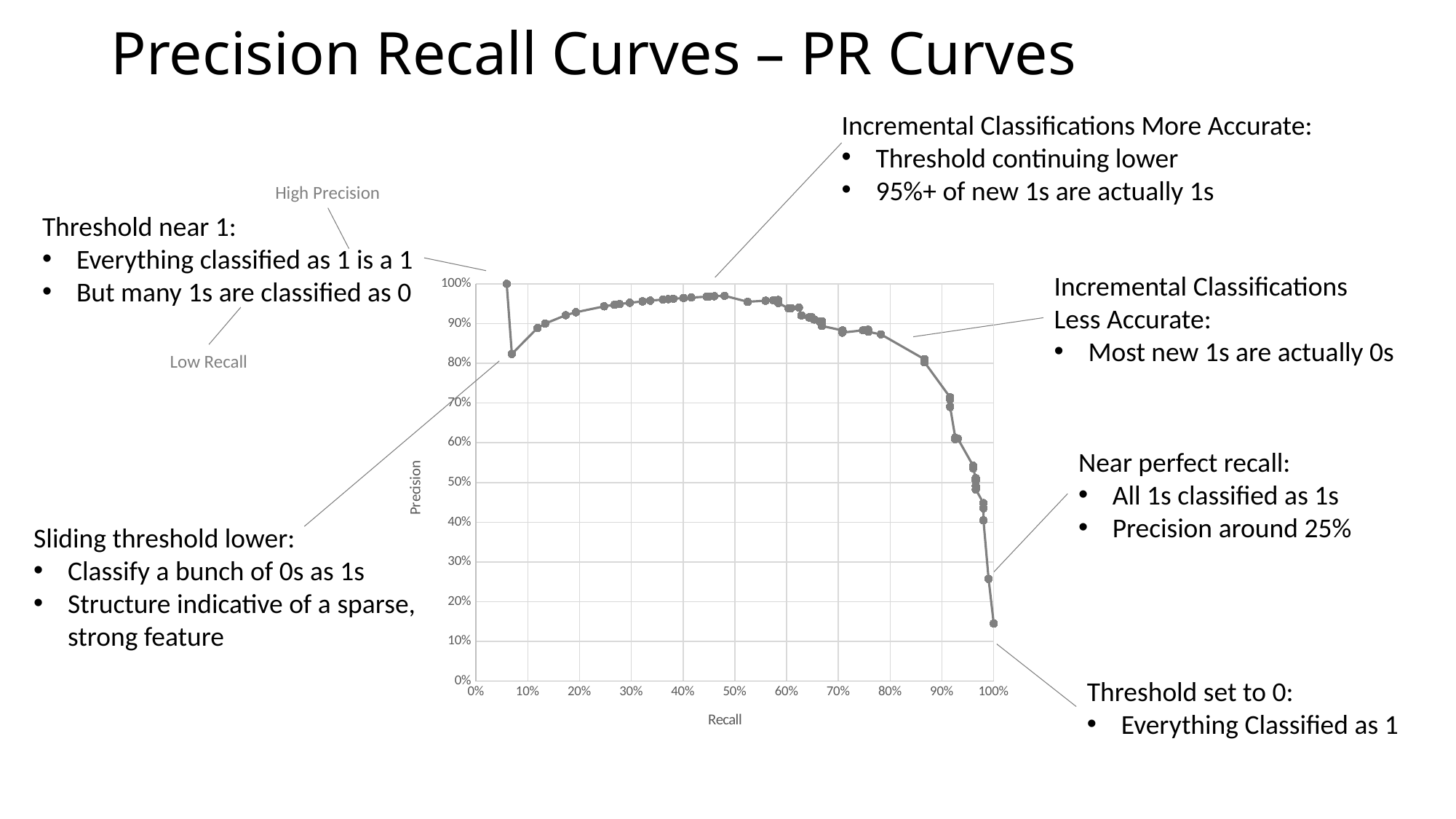
Is the precision at 30% recall greater or less than 90%? greater As recall increases from 60% to 100%, does precision rise or fall? fall What is the label of the y axis of the chart? Precision What is the label of the x axis of the chart? Recall Is the precision at 100% recall greater or less than 20%? less Is the precision at 50% recall greater or less than 90%? greater At which end of the recall axis is precision lowest? near 100% recall What kind of chart is shown on the slide? line chart Which has the higher precision: the point at 50% recall or the point at 100% recall? 50% recall Which has the higher precision: the point at 20% recall or the point at 90% recall? 20% recall What is the highest precision value reached by the curve? 100%